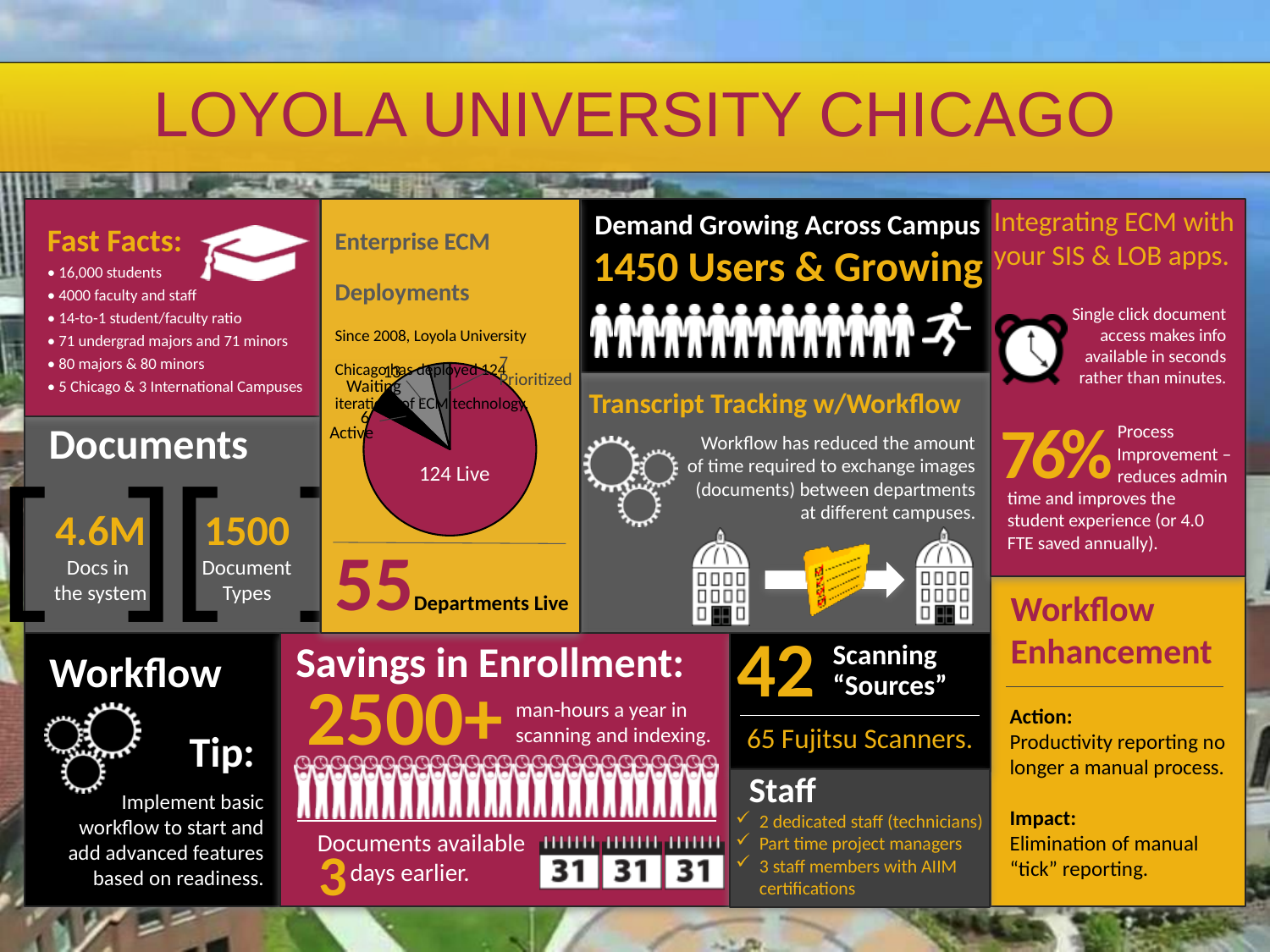
In the Enterprise ECM Deployments pie chart, what is the value for Waiting? 13 In the Enterprise ECM Deployments pie chart, what is the difference between the Waiting value and the Prioritized value? 6 In the Enterprise ECM Deployments pie chart, what is the value for Live? 124 What kind of chart is shown in the Enterprise ECM Deployments panel? pie chart In the Enterprise ECM Deployments pie chart, what is the difference between the Live value and the Waiting value? 111 What is the heading of the panel containing the pie chart? Enterprise ECM Deployments In the Enterprise ECM Deployments pie chart, what is the value for Prioritized? 7 In the Enterprise ECM Deployments pie chart, which is larger, Live or Waiting? Live How many slices does the Enterprise ECM Deployments pie chart have? 4 In the Enterprise ECM Deployments pie chart, which category has the smallest value? Active In the Enterprise ECM Deployments pie chart, which category has the largest slice? Live In the Enterprise ECM Deployments pie chart, what is the value for Active? 6